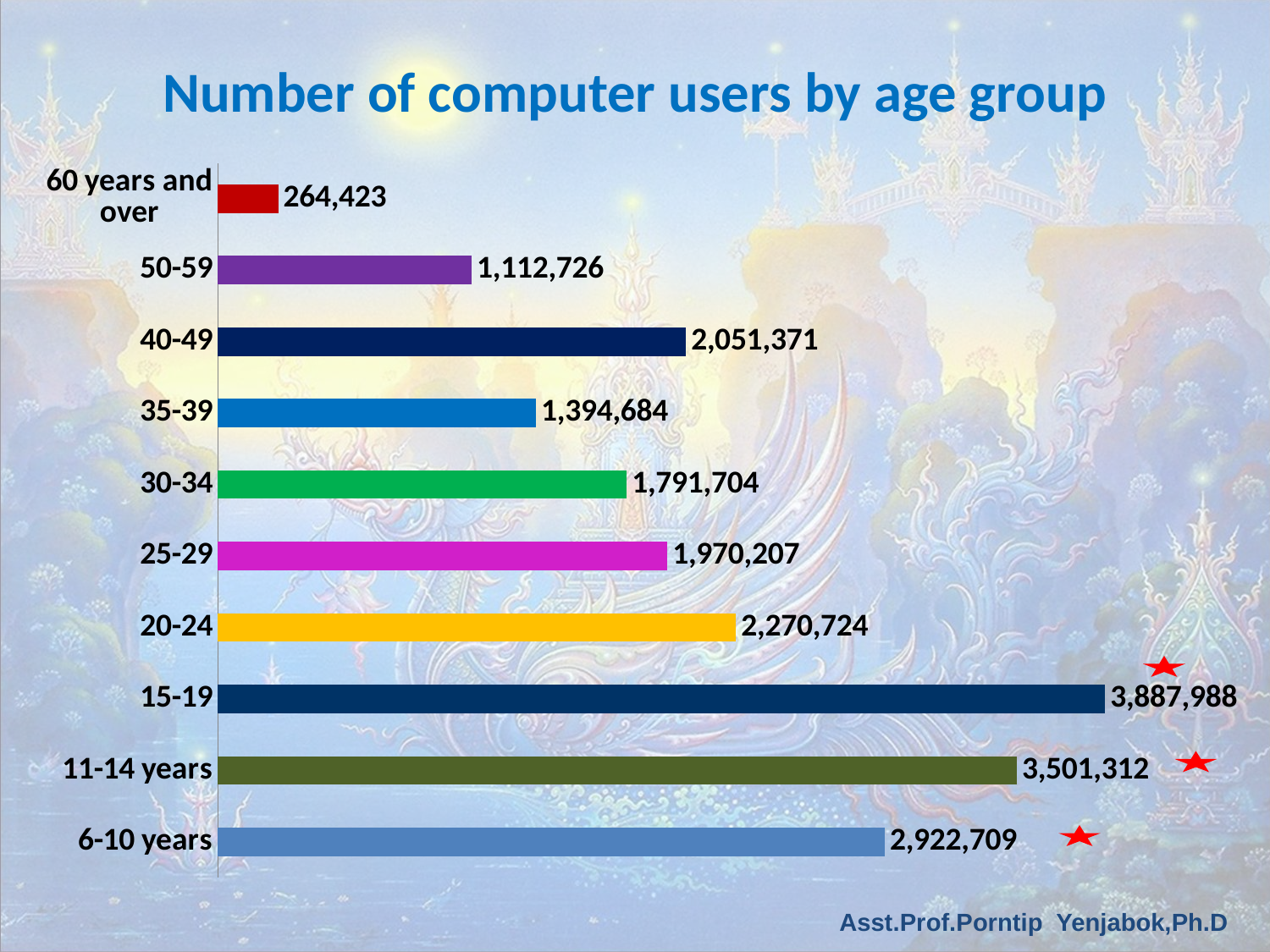
Which age group has more computer users, 6-10 years or 40-49? 6-10 years Which age group has more computer users, 20-24 or 25-29? 20-24 What is the number of computer users aged 60 years and over? 264,423 How many age groups are shown in the chart? 10 What type of chart is used to show the number of computer users by age group? Bar chart What is the title of the chart? Number of computer users by age group What is the difference in the number of computer users between the 40-49 and 35-39 age groups? 656,687 Which age group has the highest number of computer users? 15-19 What is the number of computer users in the 30-34 age group? 1,791,704 Which age group has the lowest number of computer users? 60 years and over What is the difference in the number of computer users between the 15-19 and 11-14 years age groups? 386,676 What is the number of computer users in the 15-19 age group? 3,887,988